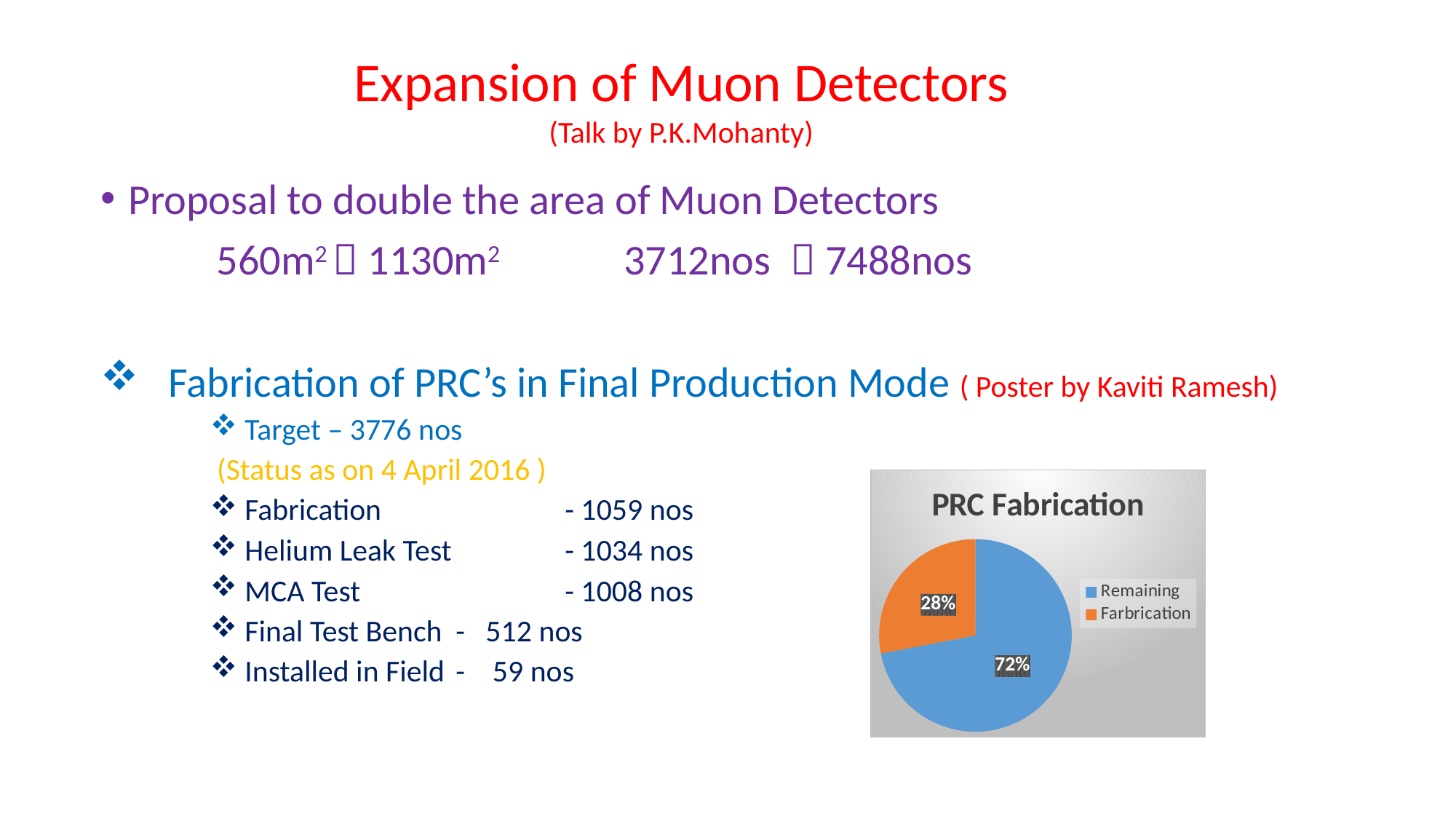
Which slice of the PRC Fabrication pie is the smallest? Farbrication What share of the PRC Fabrication pie is labelled Farbrication? 28% What is the title of the chart on the slide? PRC Fabrication Which is larger in the PRC Fabrication pie, Remaining or Farbrication? Remaining What share of the PRC Fabrication pie is labelled Remaining? 72% How many entries does the legend of the PRC Fabrication chart list? 2 What colour is the Remaining slice in the PRC Fabrication pie chart? blue How many slices does the PRC Fabrication pie chart have? 2 Which slice of the PRC Fabrication pie is the largest? Remaining What is the difference in percentage points between the Remaining and Farbrication slices? 44 What kind of chart is shown on the slide? pie chart